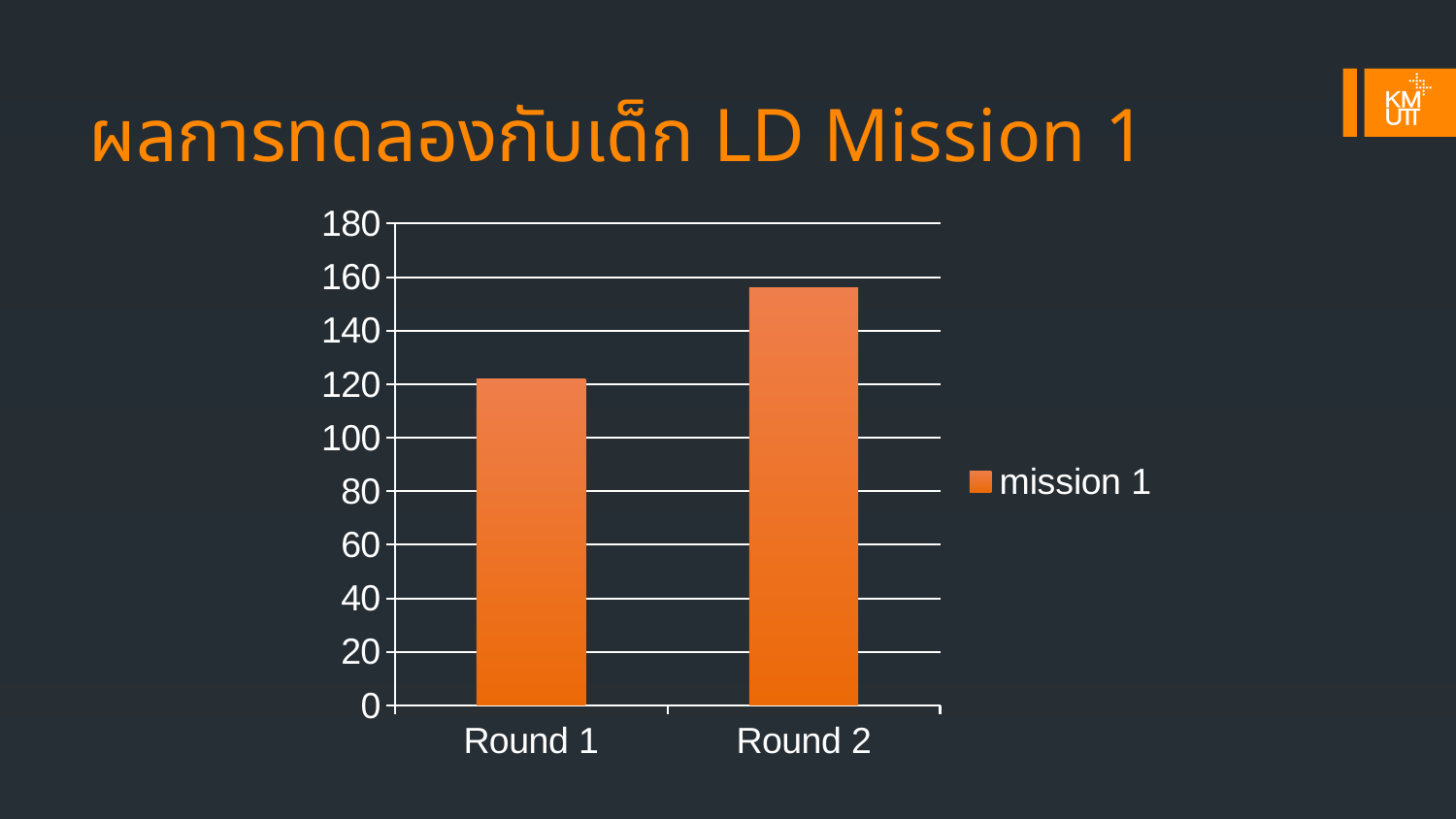
What is the name of the series shown in the chart's legend? mission 1 Is the value for Round 1 greater or less than 140? less How many series does the chart's legend list? 1 How many categories are shown on the x axis of the chart? 2 What kind of chart is shown on the slide? bar chart Which is larger, the value for Round 1 or the value for Round 2? Round 2 Is the value for Round 1 greater or less than 100? greater Is the value for Round 2 greater or less than 140? greater Which round has the highest value in the chart? Round 2 Do the values rise or fall from Round 1 to Round 2? rise Which round has the lowest value in the chart? Round 1